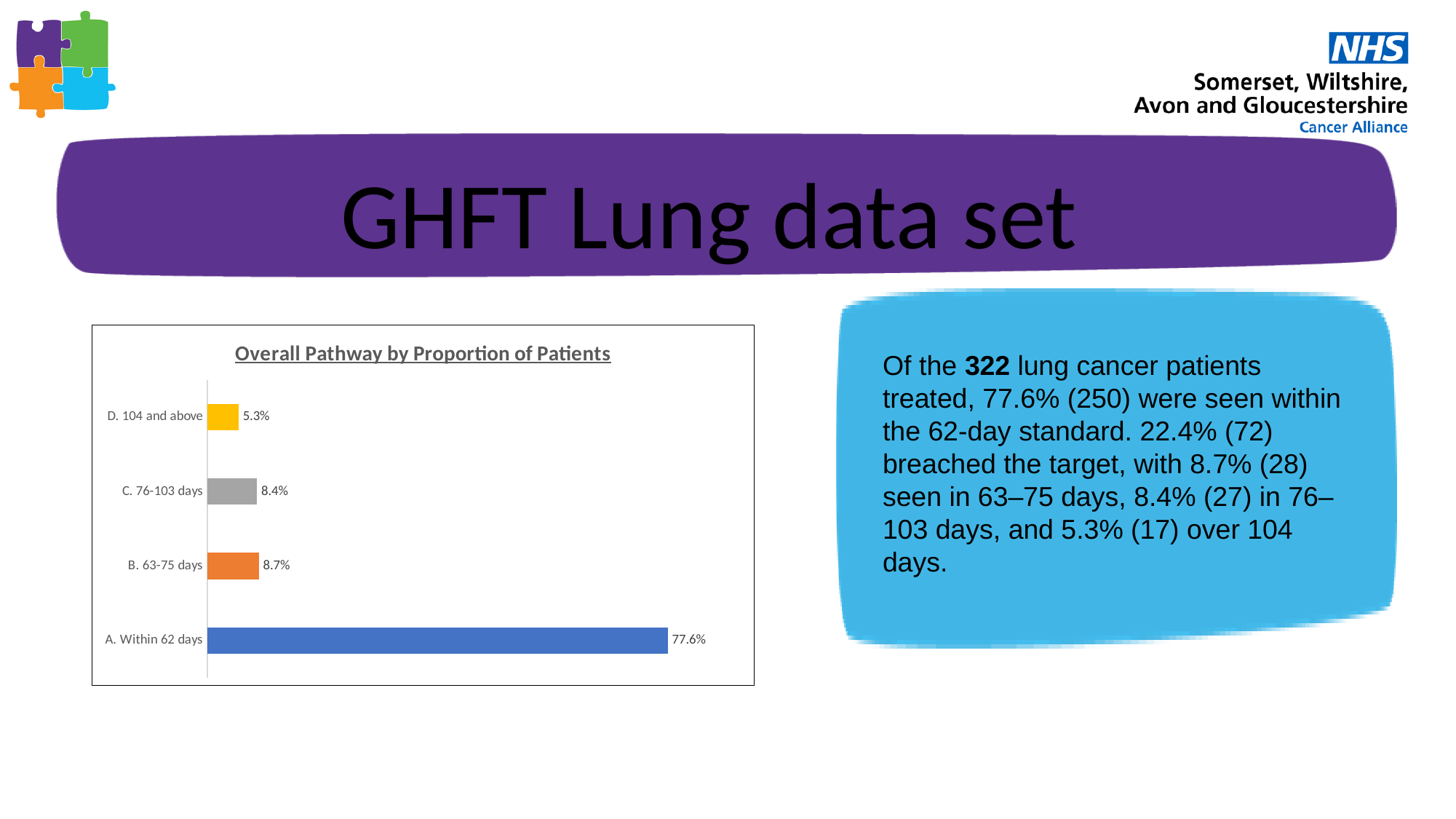
What is the difference between the values for 'A. Within 62 days' and 'B. 63-75 days'? 68.9% What is the title of the chart on the slide? Overall Pathway by Proportion of Patients What is the value for 'B. 63-75 days' in the chart? 8.7% Which category has the highest value in the chart? A. Within 62 days Which category has the lowest value in the chart? D. 104 and above How many categories are shown in the chart? 4 What is the difference between the values for 'C. 76-103 days' and 'D. 104 and above'? 3.1% What kind of chart is shown on the slide? Bar chart Which is larger, the value for 'B. 63-75 days' or 'D. 104 and above'? B. 63-75 days What is the value for 'C. 76-103 days' in the chart? 8.4% What is the value for 'A. Within 62 days' in the Overall Pathway by Proportion of Patients chart? 77.6% What is the value for 'D. 104 and above' in the chart? 5.3%